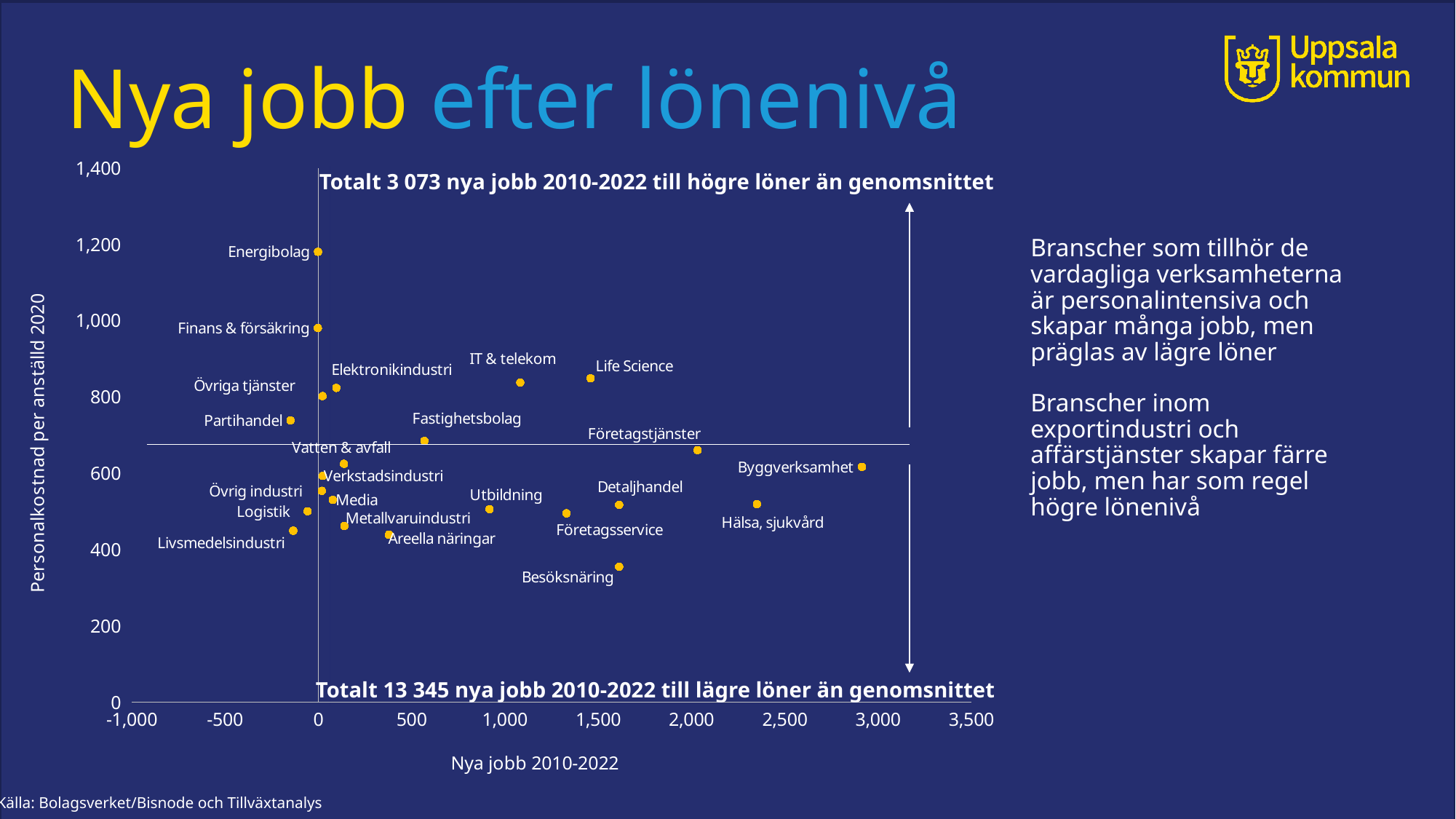
Is the personalkostnad per anställd for Energibolag greater or less than 1,000? greater Is the personalkostnad per anställd for Besöksnäring greater or less than 400? less What kind of chart is shown on the slide? scatter chart Which has more nya jobb 2010-2022, Företagstjänster or Fastighetsbolag? Företagstjänster What is the title of the x axis? Nya jobb 2010-2022 Which industry has the highest personalkostnad per anställd 2020? Energibolag According to the annotation on the chart, how many new jobs 2010-2022 went to lower wages than average? 13 345 Which industry has the lowest personalkostnad per anställd 2020? Besöksnäring Is the number of nya jobb 2010-2022 for Byggverksamhet greater or less than 2,500? greater Which industry has the most nya jobb 2010-2022? Byggverksamhet Which has a higher personalkostnad per anställd, Finans & försäkring or Detaljhandel? Finans & försäkring